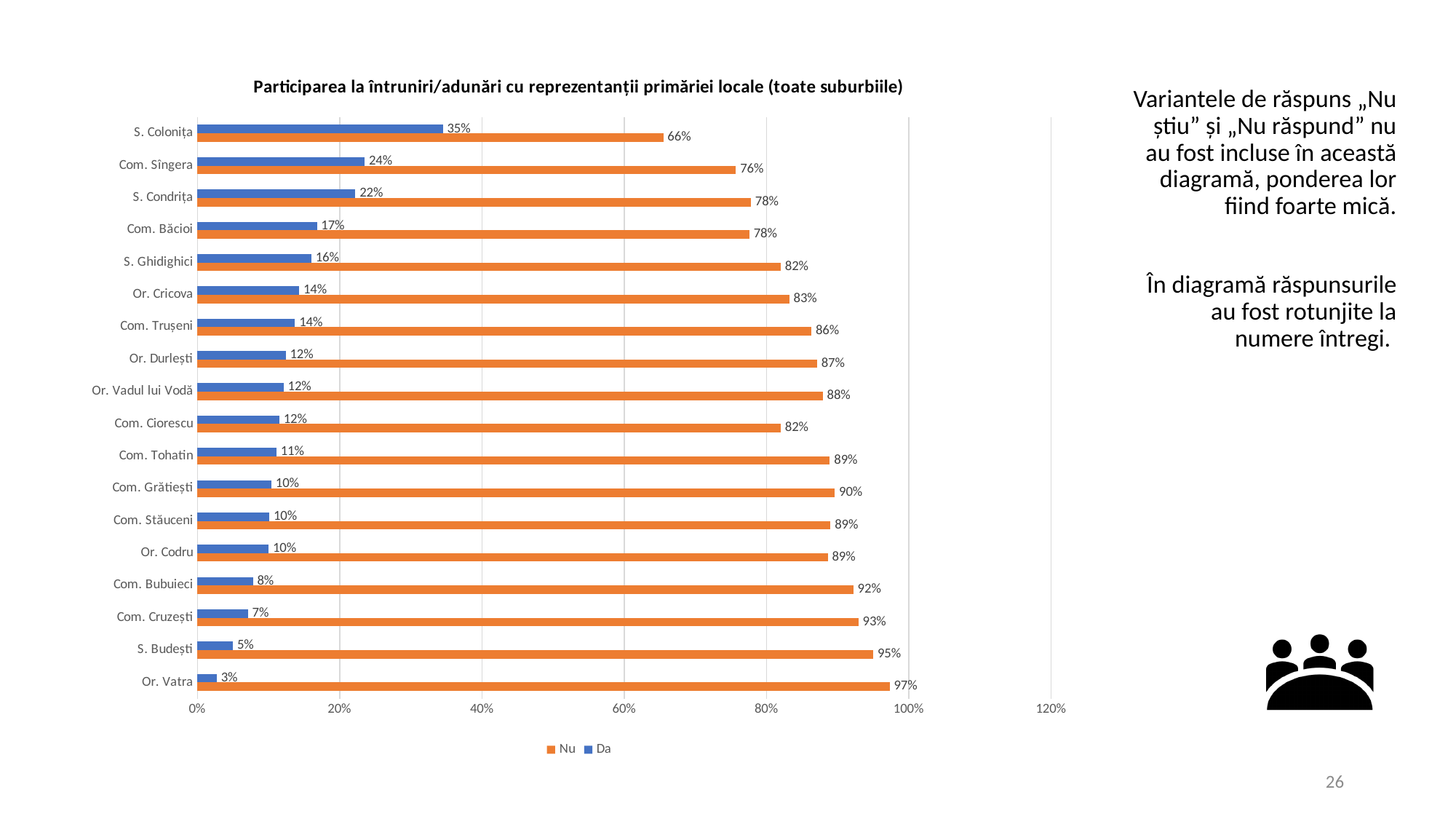
What kind of chart is shown on the slide? Bar chart How many categories (localities) are shown on the chart? 18 Which category has the lowest 'Da' value? Or. Vatra What is the difference between the 'Nu' and 'Da' values for Com. Sîngera? 52% Which is larger, the 'Da' value for Com. Băcioi or the 'Da' value for S. Ghidighici? Com. Băcioi What is the 'Nu' value for Or. Vatra? 97% How many series does the legend list? 2 What is the 'Nu' value for Com. Ciorescu? 82% Which category has the highest 'Da' value? S. Colonița Which category has the lowest 'Nu' value? S. Colonița Which colour represents the 'Nu' series? Orange What is the 'Da' value for S. Colonița? 35%